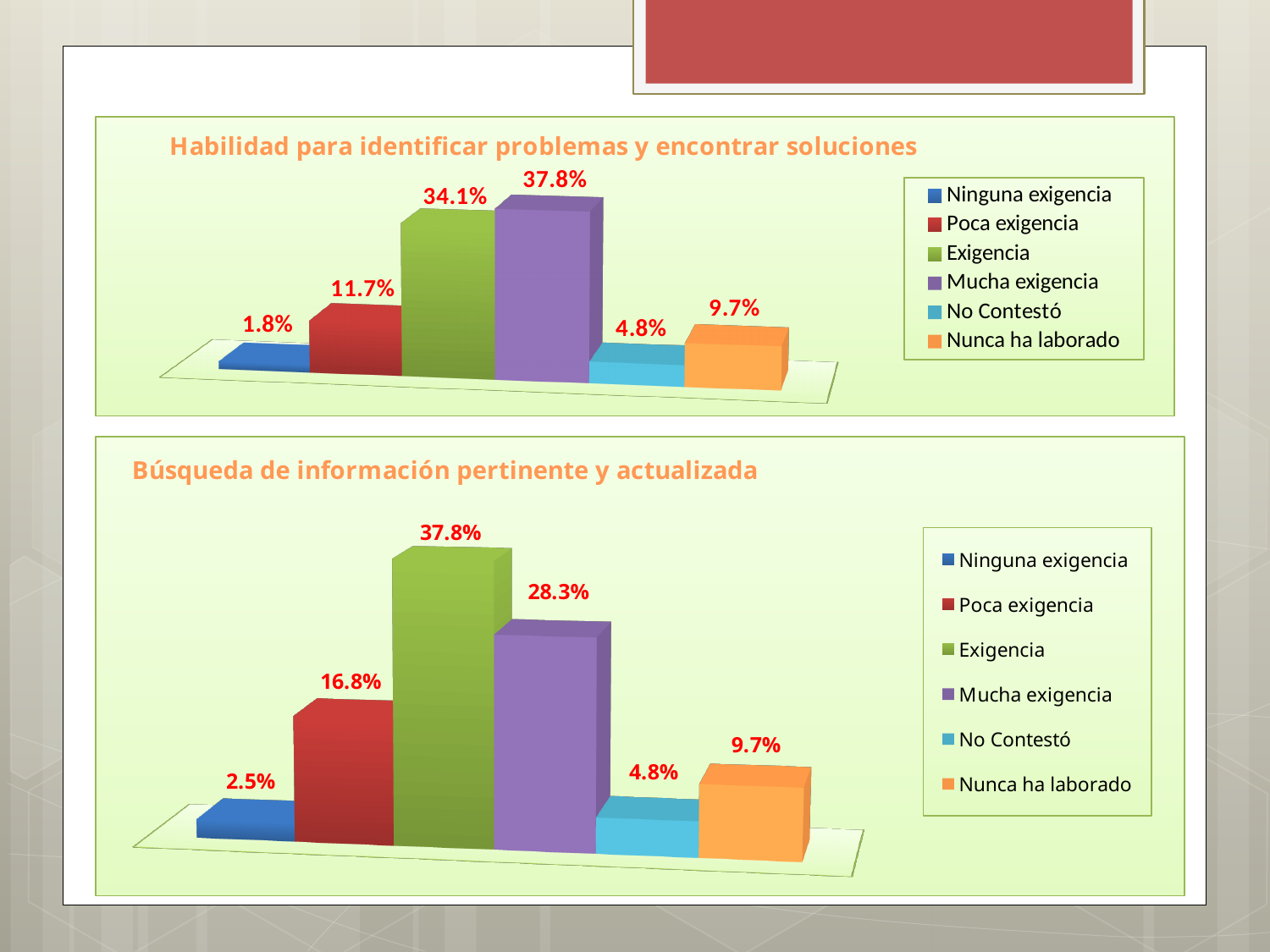
In the chart titled 'Búsqueda de información pertinente y actualizada', what is the value for 'Exigencia'? 37.8% In the chart titled 'Búsqueda de información pertinente y actualizada', what is the difference between 'Exigencia' and 'Mucha exigencia'? 9.5% In the chart titled 'Habilidad para identificar problemas y encontrar soluciones', what is the value for 'Poca exigencia'? 11.7% In the chart titled 'Habilidad para identificar problemas y encontrar soluciones', which category has the lowest value? Ninguna exigencia In the chart titled 'Habilidad para identificar problemas y encontrar soluciones', what is the difference between 'Mucha exigencia' and 'Exigencia'? 3.7% In the chart titled 'Habilidad para identificar problemas y encontrar soluciones', how many entries does the legend list? 6 In the chart titled 'Búsqueda de información pertinente y actualizada', which is larger, 'Poca exigencia' or 'Nunca ha laborado'? Poca exigencia In the chart titled 'Búsqueda de información pertinente y actualizada', what is the value for 'Ninguna exigencia'? 2.5% What kind of chart is the bottom chart on the slide? Bar chart In the chart titled 'Habilidad para identificar problemas y encontrar soluciones', what is the value for 'Mucha exigencia'? 37.8% How many bars are plotted in the top chart on the slide? 6 In the chart titled 'Búsqueda de información pertinente y actualizada', which category has the highest value? Exigencia